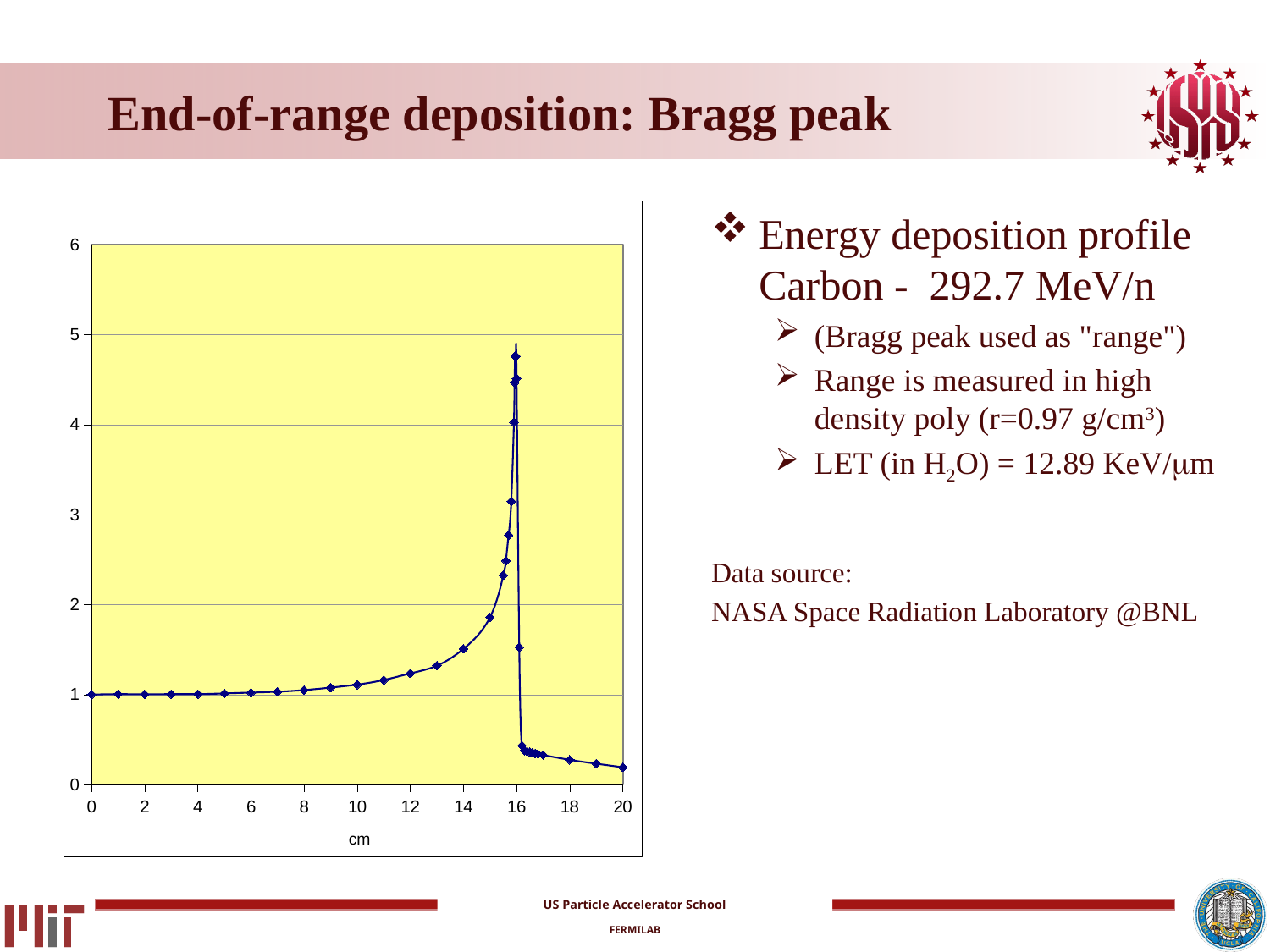
Is the peak value of the curve greater or less than 4? greater Do the values rise or fall along the x axis between 0 cm and 14 cm? rise Which is larger, the value at 2 cm or the value at 13 cm? 13 cm Is the value at 14 cm greater or less than 1? greater Do the values rise or fall along the x axis between 17 cm and 20 cm? fall Near which x-axis tick does the sharp peak of the curve occur? 16 What is the highest tick value shown on the y axis of the chart? 6 Which is larger, the value at 14 cm or the value at 18 cm? 14 cm Is the value at 10 cm greater or less than 2? less What is the label of the x axis of the chart? cm What kind of chart is shown on the slide? line chart